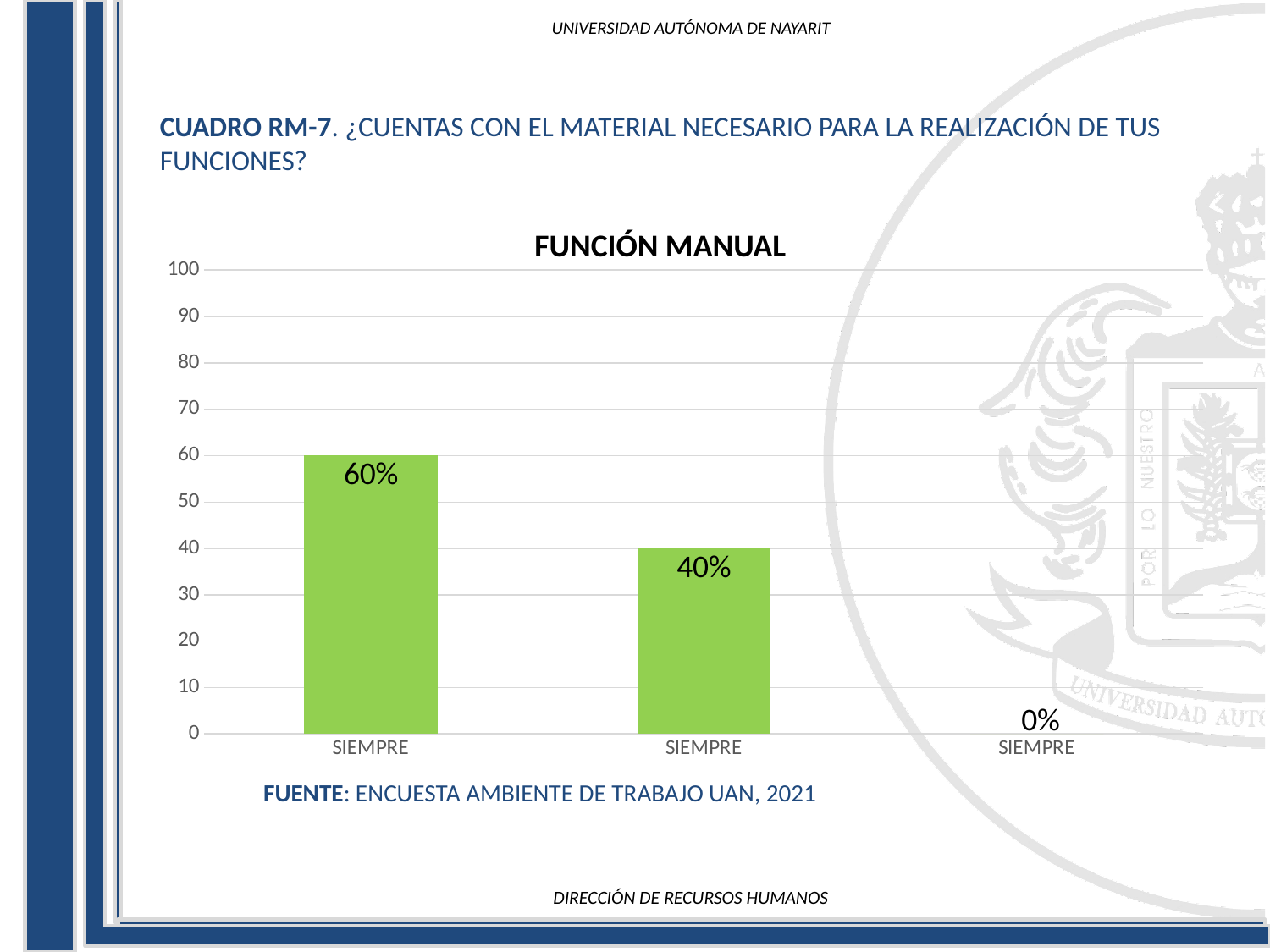
Do the values rise or fall from left to right across the chart? fall What is the value shown for the rightmost category in the chart? 0% What kind of chart is shown on the slide? bar chart What is the maximum value shown on the vertical axis of the chart? 100 Which category has the lowest value in the chart? the rightmost category (0%) Which bar has the highest value in the chart? the leftmost bar (60%) What is the value shown for the middle bar in the chart? 40% Which is larger, the leftmost bar or the middle bar? the leftmost bar How many bars (categories) are plotted in the chart? 3 What is the title of the chart? FUNCIÓN MANUAL What is the value shown for the leftmost bar in the chart? 60% What is the difference between the leftmost bar and the middle bar in the chart? 20%